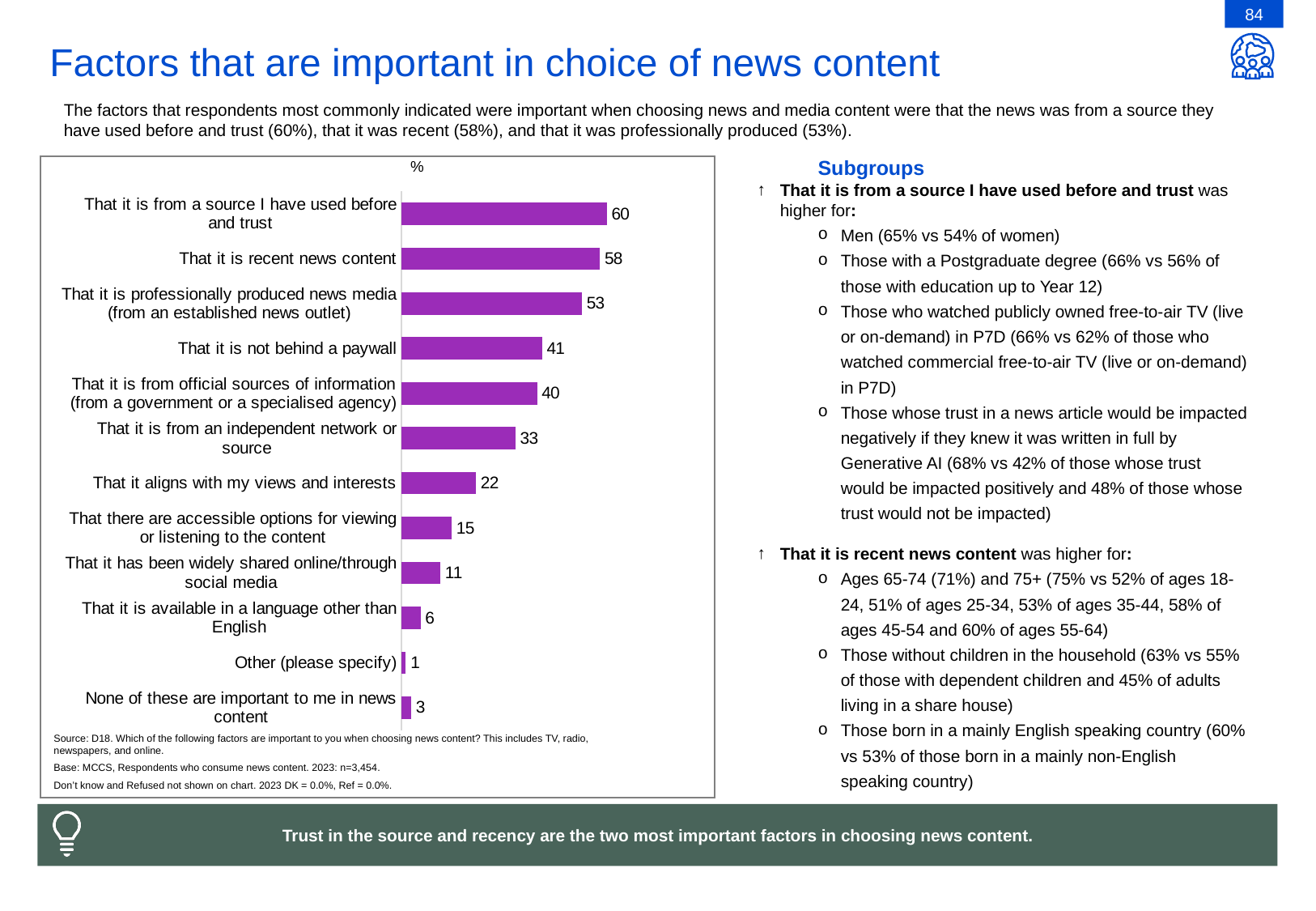
What is the difference between 'That it is recent news content' and 'That it is professionally produced news media (from an established news outlet)'? 5 Which is larger: 'That it aligns with my views and interests' or 'That there are accessible options for viewing or listening to the content'? That it aligns with my views and interests What is the difference between 'That it is not behind a paywall' and 'That it is from official sources of information (from a government or a specialised agency)'? 1 What kind of chart is shown on the slide? Bar chart Which category has the highest value? That it is from a source I have used before and trust What is the value for 'That it is not behind a paywall'? 41 How many categories are shown in the chart? 12 What colour are the bars in the chart? Purple What is the value for 'That it is available in a language other than English'? 6 Which category has the lowest value? Other (please specify) What is the value for 'That it has been widely shared online/through social media'? 11 What is the value for 'That it is from a source I have used before and trust'? 60